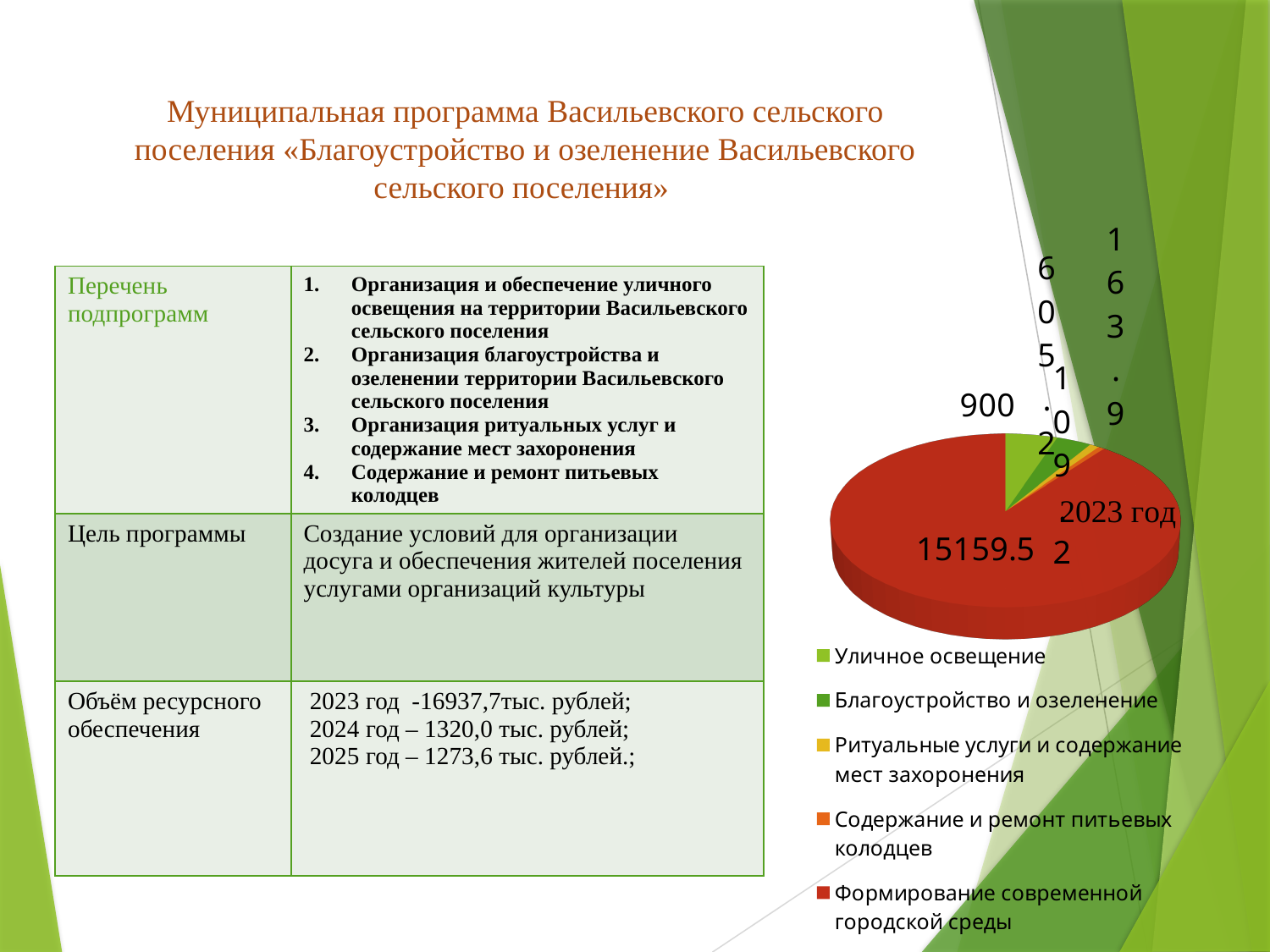
What value is labelled for Формирование современной городской среды in the pie chart? 15159.5 What kind of chart is shown on the right side of the slide? pie chart Which category has the largest slice in the pie chart? Формирование современной городской среды How many entries does the pie chart's legend list? 5 What colour is the slice for Формирование современной городской среды in the pie chart? red What value is labelled for Уличное освещение in the pie chart? 900 How many slices does the pie chart have? 5 Which is larger in the pie chart: Формирование современной городской среды or Уличное освещение? Формирование современной городской среды